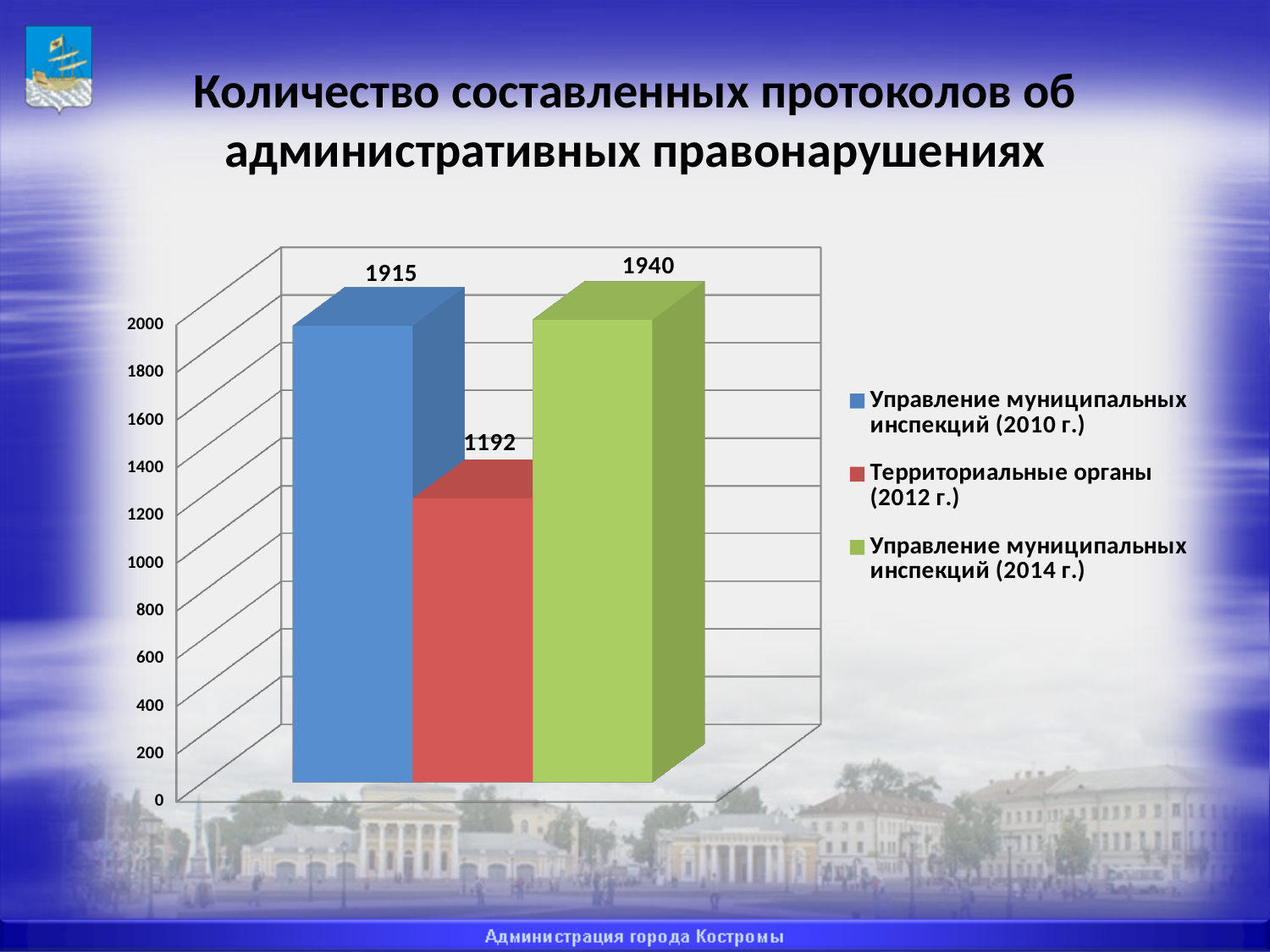
Which series has the highest value? Управление муниципальных инспекций (2014 г.) What is the value for Территориальные органы (2012 г.)? 1192 What is the value for Управление муниципальных инспекций (2014 г.)? 1940 How many series does the legend list? 3 What kind of chart is shown on the slide? bar chart Is the value for Территориальные органы (2012 г.) greater or less than 1400? less What is the difference between the values for Управление муниципальных инспекций (2014 г.) and Территориальные органы (2012 г.)? 748 What is the difference between the values for Управление муниципальных инспекций (2010 г.) and Территориальные органы (2012 г.)? 723 Which is larger: the value for Управление муниципальных инспекций (2010 г.) or Территориальные органы (2012 г.)? Управление муниципальных инспекций (2010 г.) Which series has the lowest value? Территориальные органы (2012 г.) What colour is the bar for Территориальные органы (2012 г.)? red What is the value for Управление муниципальных инспекций (2010 г.)? 1915